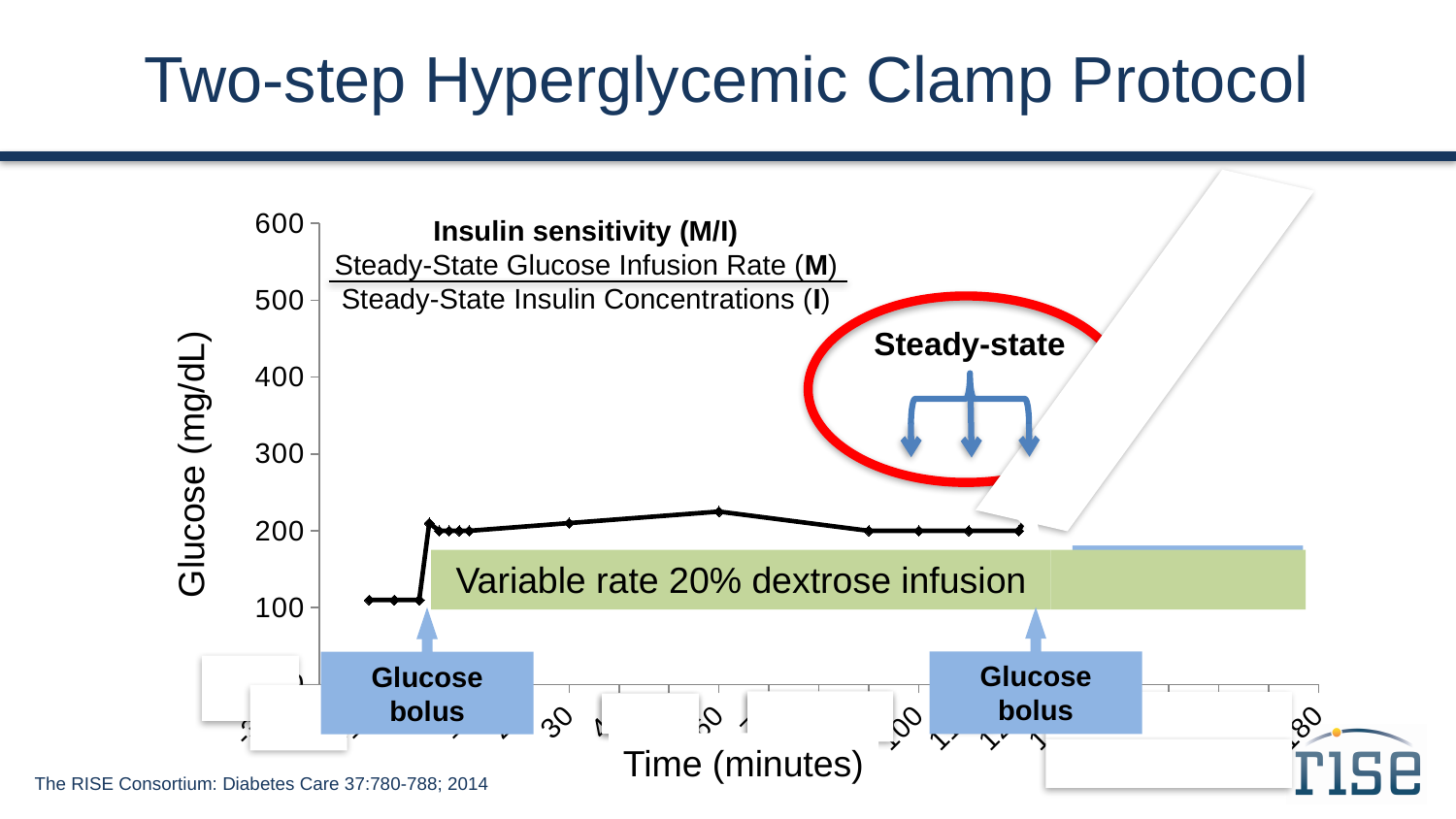
How many tick labels are shown on the vertical axis of the chart? 6 What is the label of the vertical axis of the chart? Glucose (mg/dL) Does the plotted glucose value rise or fall immediately after the first glucose bolus? rise What text appears inside the red circle on the chart? Steady-state What is the last tick label shown on the horizontal axis of the chart? 180 What is the highest value shown on the vertical axis of the chart? 600 What is the lowest tick value shown on the vertical axis of the chart? 100 Is the glucose value before the first glucose bolus greater or less than 200 mg/dL? less Is the highest glucose value plotted on the chart greater or less than 100 mg/dL? greater What kind of chart is shown on the slide? line chart